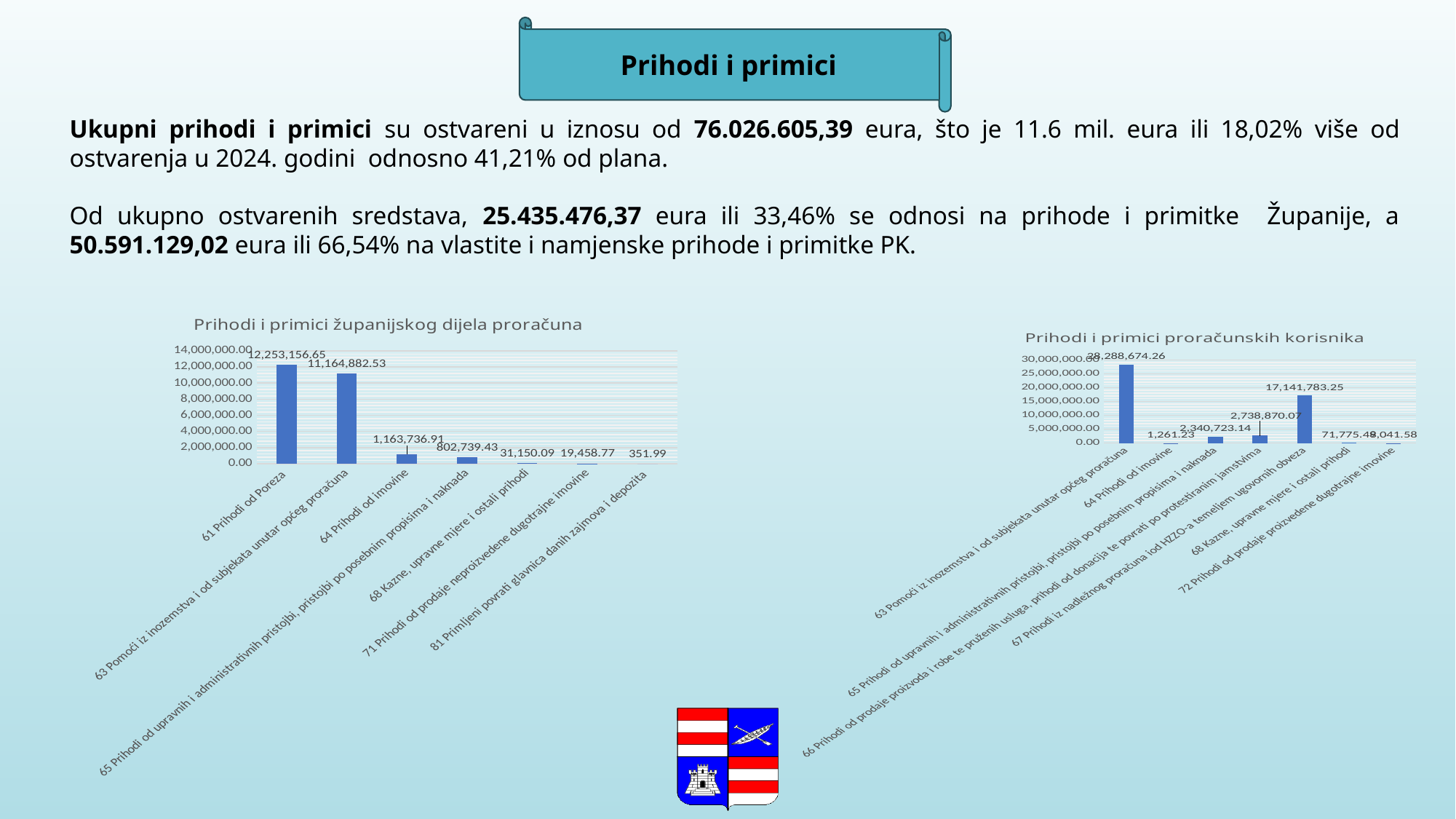
In the chart 'Prihodi i primici županijskog dijela proračuna', what is the value for '64 Prihodi od imovine'? 1,163,736.91 In the chart 'Prihodi i primici proračunskih korisnika', what is the value for '67 Prihodi iz nadležnog proračuna i od HZZO-a temeljem ugovornih obveza'? 17,141,783.25 In the chart 'Prihodi i primici županijskog dijela proračuna', what is the difference between '61 Prihodi od poreza' and '63 Pomoći iz inozemstva i od subjekata unutar općeg proračuna'? 1,088,274.12 In the chart 'Prihodi i primici proračunskih korisnika', what is the value for '66 Prihodi od prodaje proizvoda i robe te pruženih usluga, prihodi od donacija te povrati po protestiranim jamstvima'? 2,738,870.07 In the chart 'Prihodi i primici proračunskih korisnika', is the value for '67 Prihodi iz nadležnog proračuna i od HZZO-a temeljem ugovornih obveza' greater or less than 15,000,000.00? greater What type of chart is 'Prihodi i primici proračunskih korisnika'? bar chart In the chart 'Prihodi i primici proračunskih korisnika', which category has the highest value? 63 Pomoći iz inozemstva i od subjekata unutar općeg proračuna In the chart 'Prihodi i primici proračunskih korisnika', which is larger: '65 Prihodi od upravnih i administrativnih pristojbi, pristojbi po posebnim propisima i naknada' or '66 Prihodi od prodaje proizvoda i robe te pruženih usluga, prihodi od donacija te povrati po protestiranim jamstvima'? 66 Prihodi od prodaje proizvoda i robe te pruženih usluga, prihodi od donacija te povrati po protestiranim jamstvima In the chart 'Prihodi i primici županijskog dijela proračuna', what is the value for '61 Prihodi od poreza'? 12,253,156.65 In the chart 'Prihodi i primici županijskog dijela proračuna', which category has the highest value? 61 Prihodi od poreza In the chart 'Prihodi i primici županijskog dijela proračuna', which category has the lowest value? 81 Primljeni povrati glavnica danih zajmova i depozita How many categories are shown in the chart 'Prihodi i primici županijskog dijela proračuna'? 7